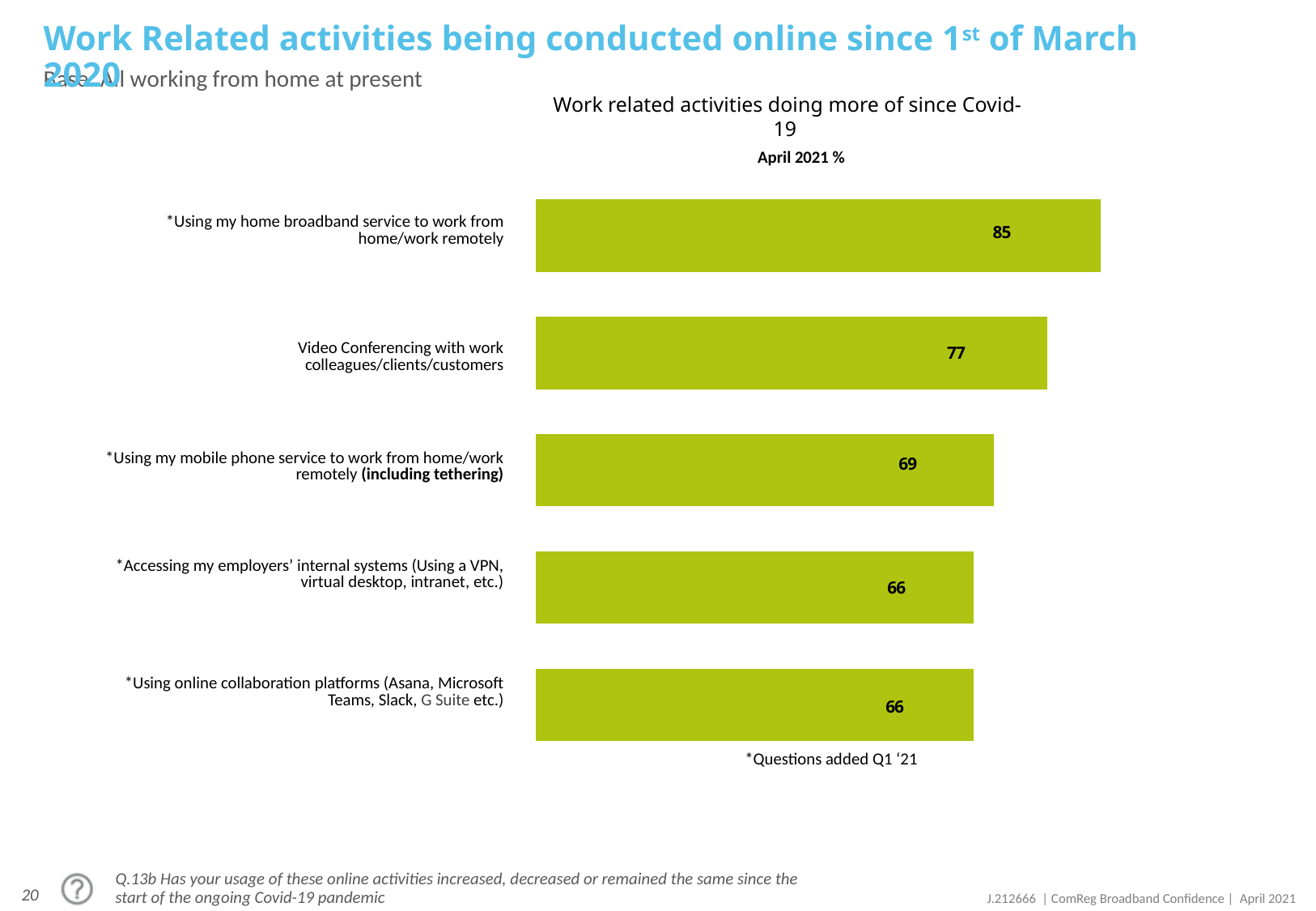
What kind of chart is shown on the slide? Bar chart Which month and year does the chart's data refer to? April 2021 What is the value for 'Using my home broadband service to work from home/work remotely'? 85 How many activities are shown in the chart? 5 What is the value for 'Video Conferencing with work colleagues/clients/customers'? 77 What is the difference between the value for video conferencing and the value for using mobile phone service to work remotely? 8 What is the value for 'Using my mobile phone service to work from home/work remotely (including tethering)'? 69 Which is larger: the value for video conferencing or the value for accessing employers' internal systems? Video Conferencing with work colleagues/clients/customers Which activity has the highest value? Using my home broadband service to work from home/work remotely What is the difference between the value for using home broadband service to work remotely and the value for video conferencing? 8 What is the title of the chart? Work related activities doing more of since Covid-19 What is the value for 'Accessing my employers' internal systems (Using a VPN, virtual desktop, intranet, etc.)'? 66